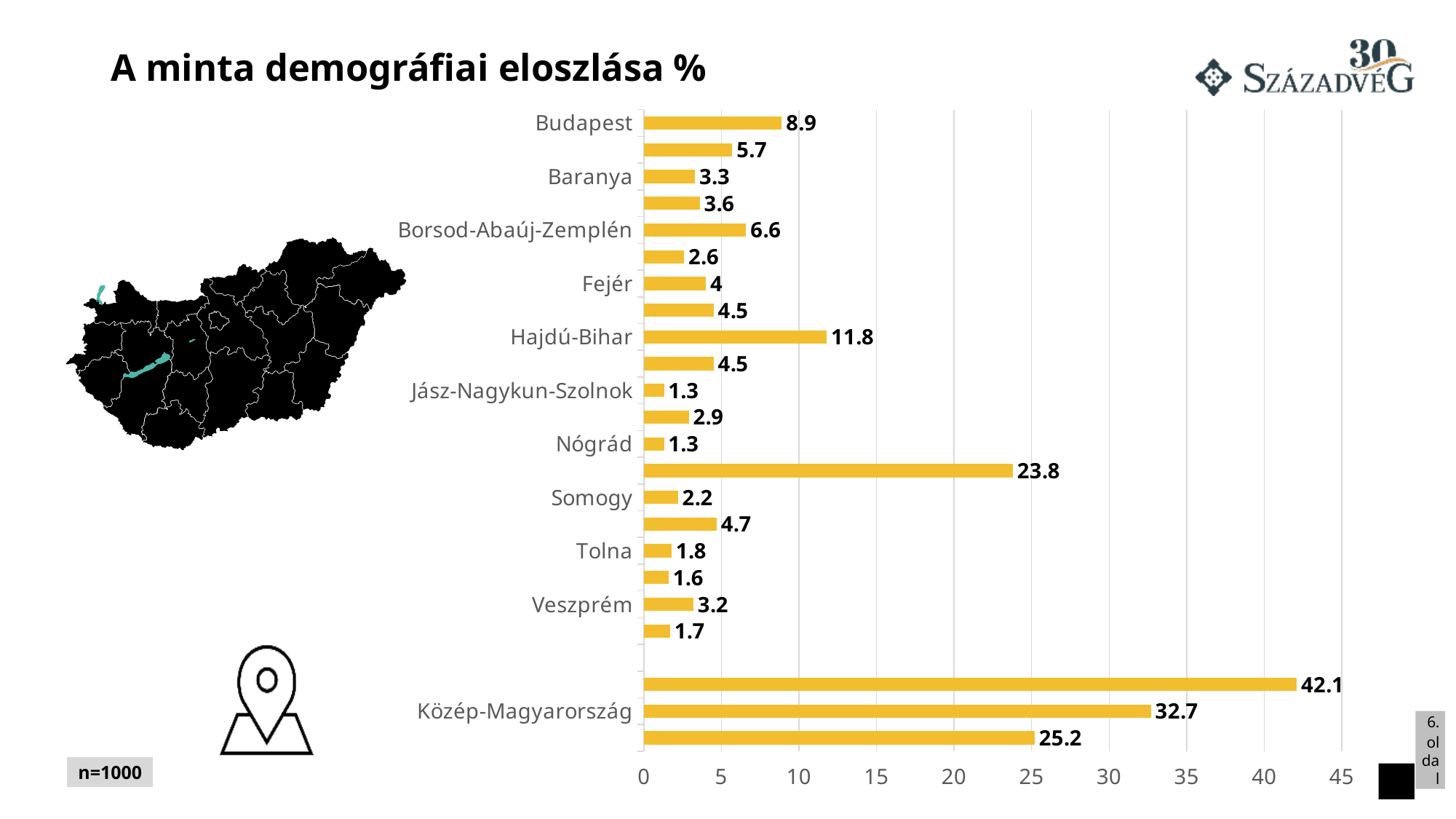
Which is larger, the value for Budapest or the value for Hajdú-Bihar? Hajdú-Bihar What is the value for Borsod-Abaúj-Zemplén? 6.6 What is the value for Nógrád? 1.3 What is the difference between the values for Budapest and Baranya? 5.6 Which is larger, the value for Tolna or the value for Somogy? Somogy What kind of chart is shown on the slide? bar chart What is the value for Hajdú-Bihar? 11.8 What is the largest value shown on the chart? 42.1 What is the value for Fejér? 4 What is the difference between the values for Hajdú-Bihar and Budapest? 2.9 What is the title of the chart? A minta demográfiai eloszlása % What is the value for Budapest? 8.9